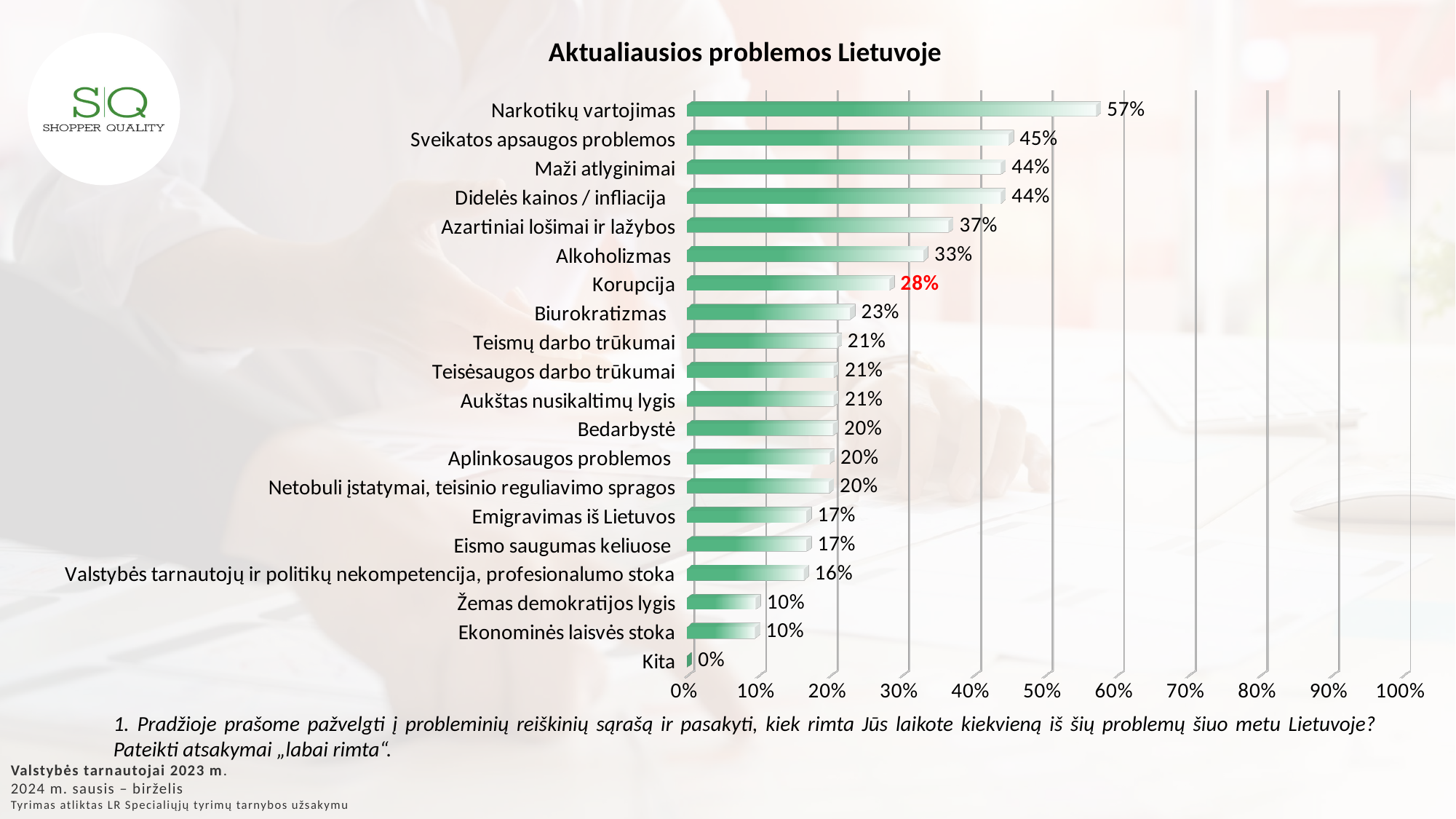
Which is larger, Azartiniai lošimai ir lažybos or Biurokratizmas? Azartiniai lošimai ir lažybos What is the title of the chart? Aktualiausios problemos Lietuvoje What is the value for Žemas demokratijos lygis? 10% Which category has the highest value? Narkotikų vartojimas Which category has the lowest value? Kita What is the difference between Narkotikų vartojimas and Sveikatos apsaugos problemos? 12% What is the difference between Alkoholizmas and Korupcija? 5% Is the value for Emigravimas iš Lietuvos greater or less than 20%? less What kind of chart is shown on the slide? bar chart How many categories are shown in the chart? 20 What is the value for Narkotikų vartojimas? 57% What is the value for Korupcija? 28%